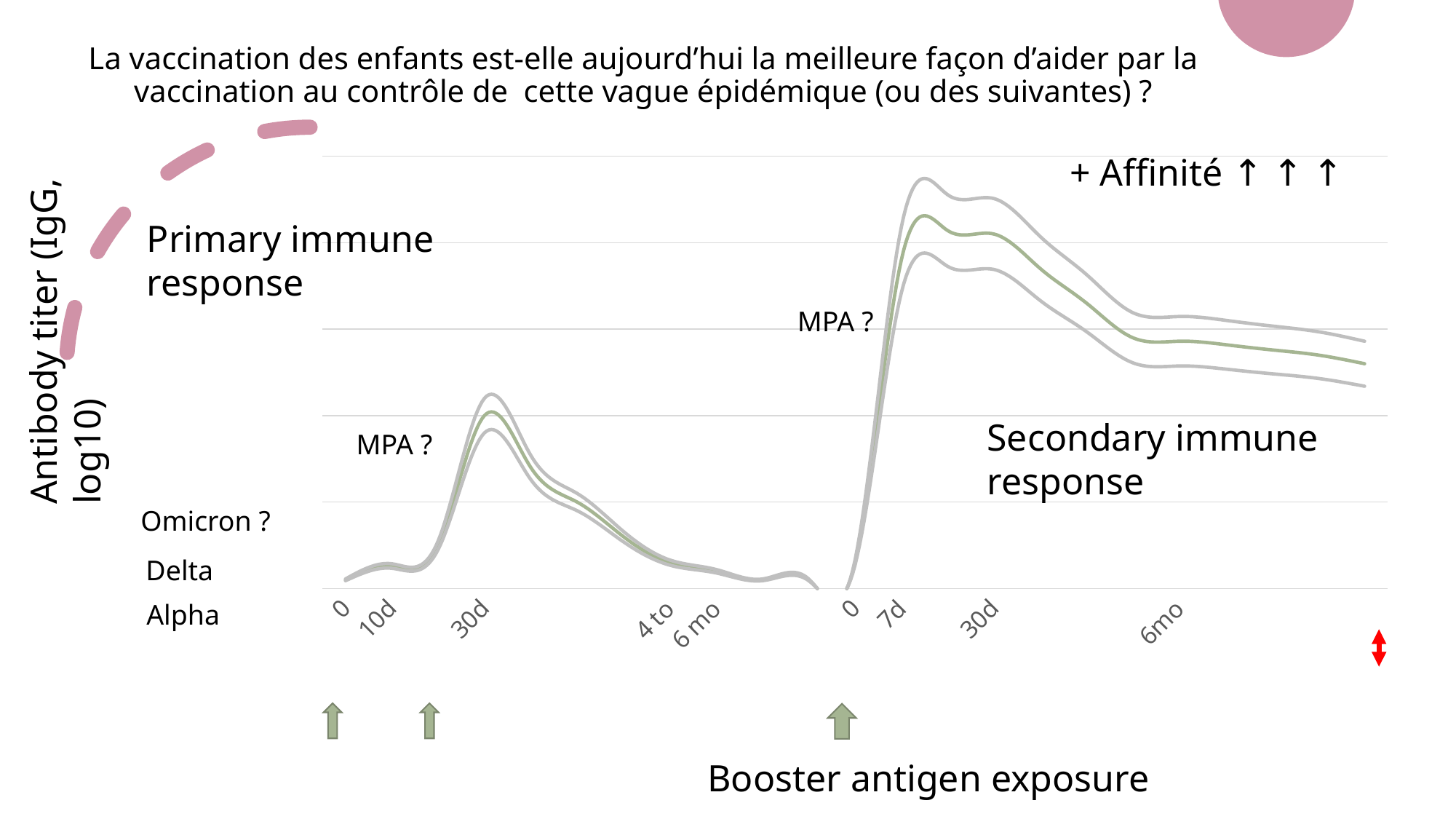
What text is written below the chart next to the green arrows? Booster antigen exposure What kind of chart is shown on the slide? Line chart How many lines are plotted for each immune response curve? 3 In the primary immune response, do the antibody titer values rise or fall between 0 and 30d? Rise What is the label of the y axis? Antibody titer (IgG, log10) In the primary immune response, do the values rise or fall from the 30d peak toward 4 to 6 mo? Fall In the secondary immune response, do the values rise or fall from 30d toward 6mo? Fall Is the antibody titer at 6mo in the secondary immune response higher or lower than the 30d peak of the primary immune response? Higher Is the peak of the secondary immune response higher or lower than the peak of the primary immune response? Higher Which immune response reaches the higher peak antibody titer, the primary or the secondary? Secondary immune response